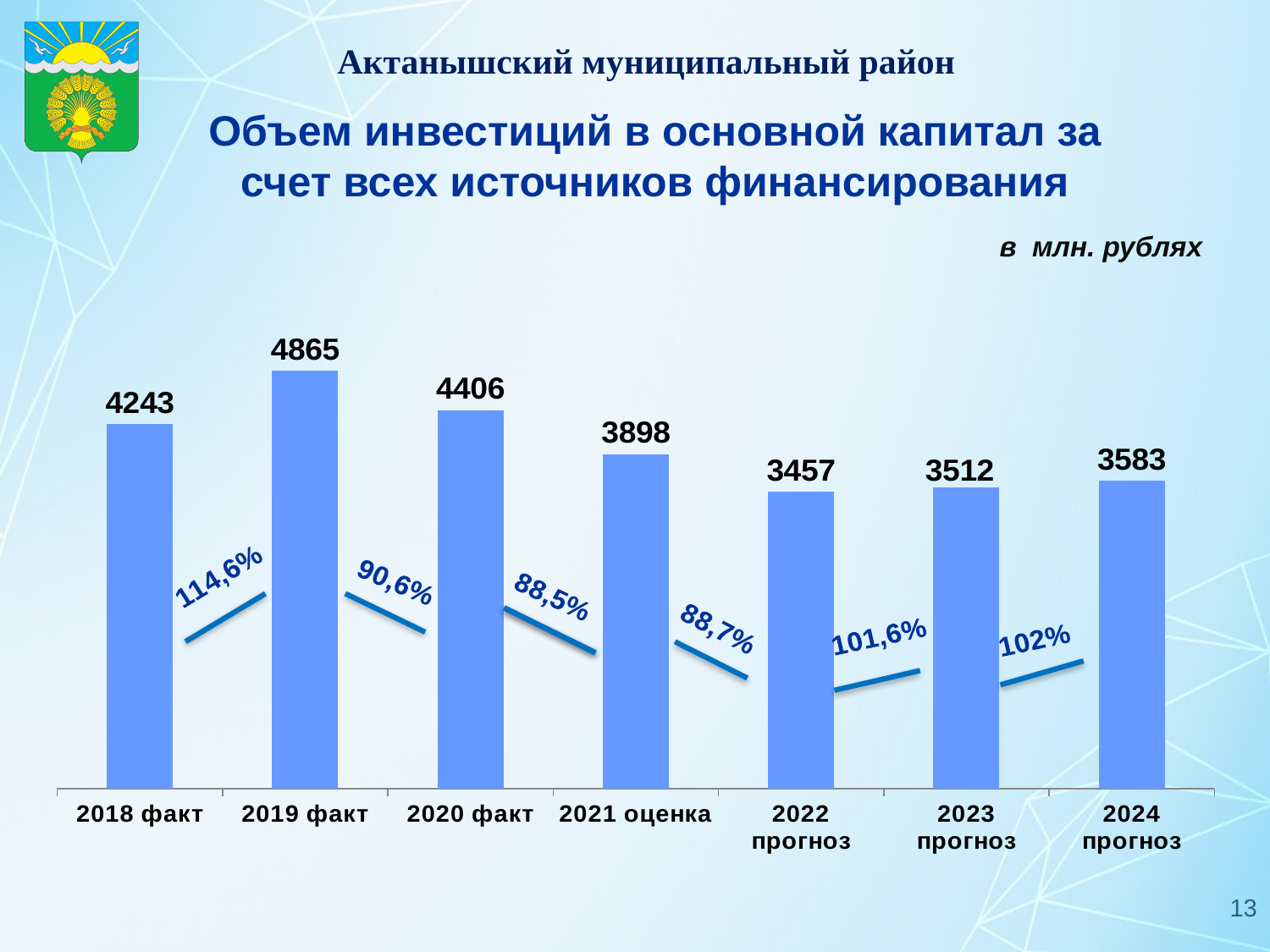
What is the value for 2019 факт? 4865 Which category has the lowest value? 2022 прогноз What is the difference between the values for 2024 прогноз and 2023 прогноз? 71 Which is larger, the value for 2018 факт or the value for 2020 факт? 2020 факт Which category has the highest value? 2019 факт How many categories are shown on the x axis? 7 What percentage is shown between 2018 факт and 2019 факт? 114,6% Do the values rise or fall from 2019 факт to 2022 прогноз? fall What is the value for 2021 оценка? 3898 What is the value for 2022 прогноз? 3457 What is the difference between the values for 2019 факт and 2020 факт? 459 What kind of chart is this? bar chart